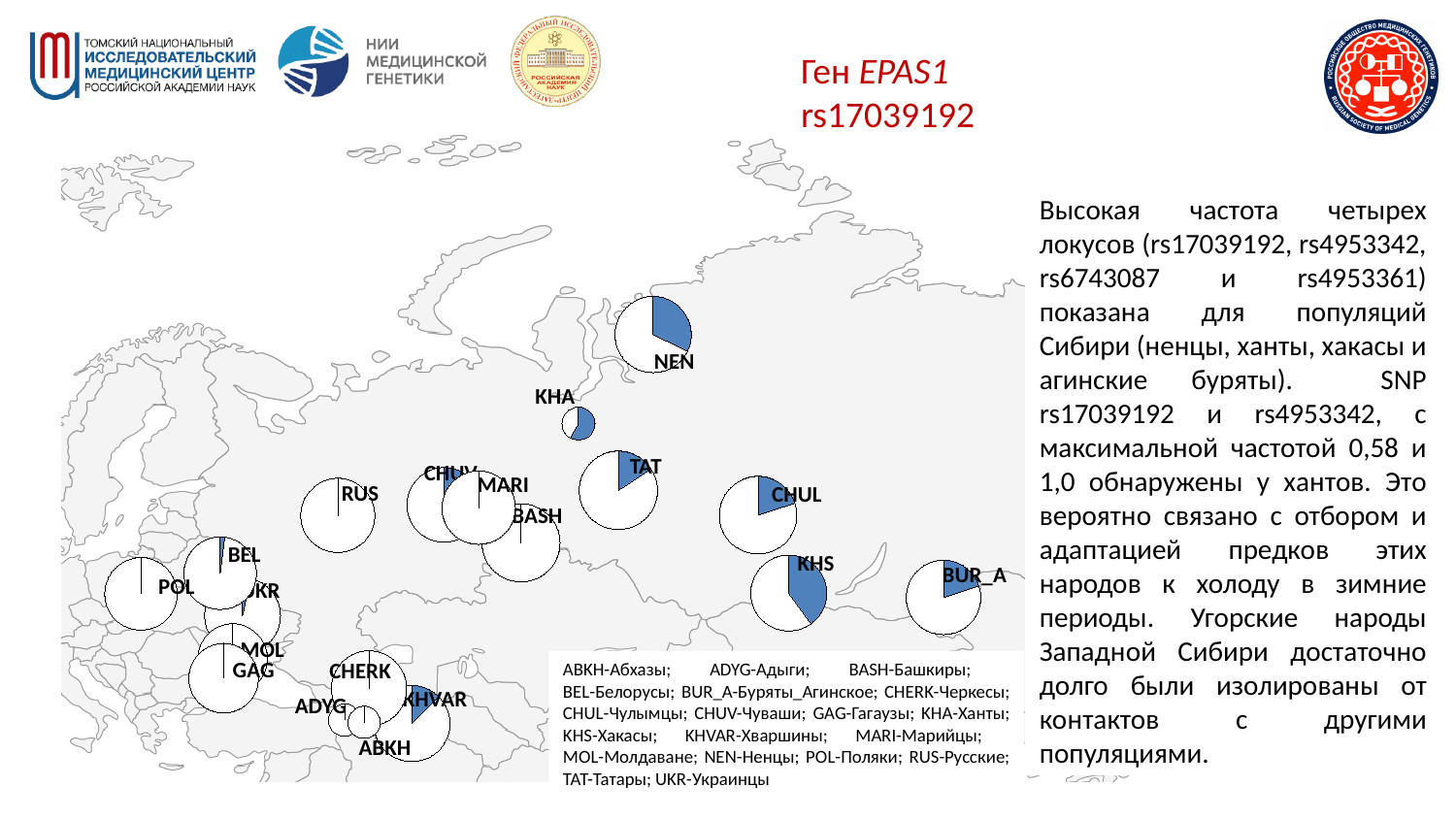
Which population has the larger blue share of its pie: KHS or ABKH? KHS Is the blue share of the KHS pie greater or less than half of the pie? less How many population pie charts are plotted on the map? 19 What kind of chart is used on the map to show the allele frequency for each population? pie chart According to the legend box, which population does the abbreviation KHS stand for? Хакасы How many population abbreviations are explained in the legend box at the bottom of the map? 19 Which population has the larger blue share of its pie: KHA or POL? KHA Which gene and SNP are named in the title of the slide? EPAS1, rs17039192 Which population has the larger blue (highlighted allele) share of its pie: KHS or RUS? KHS